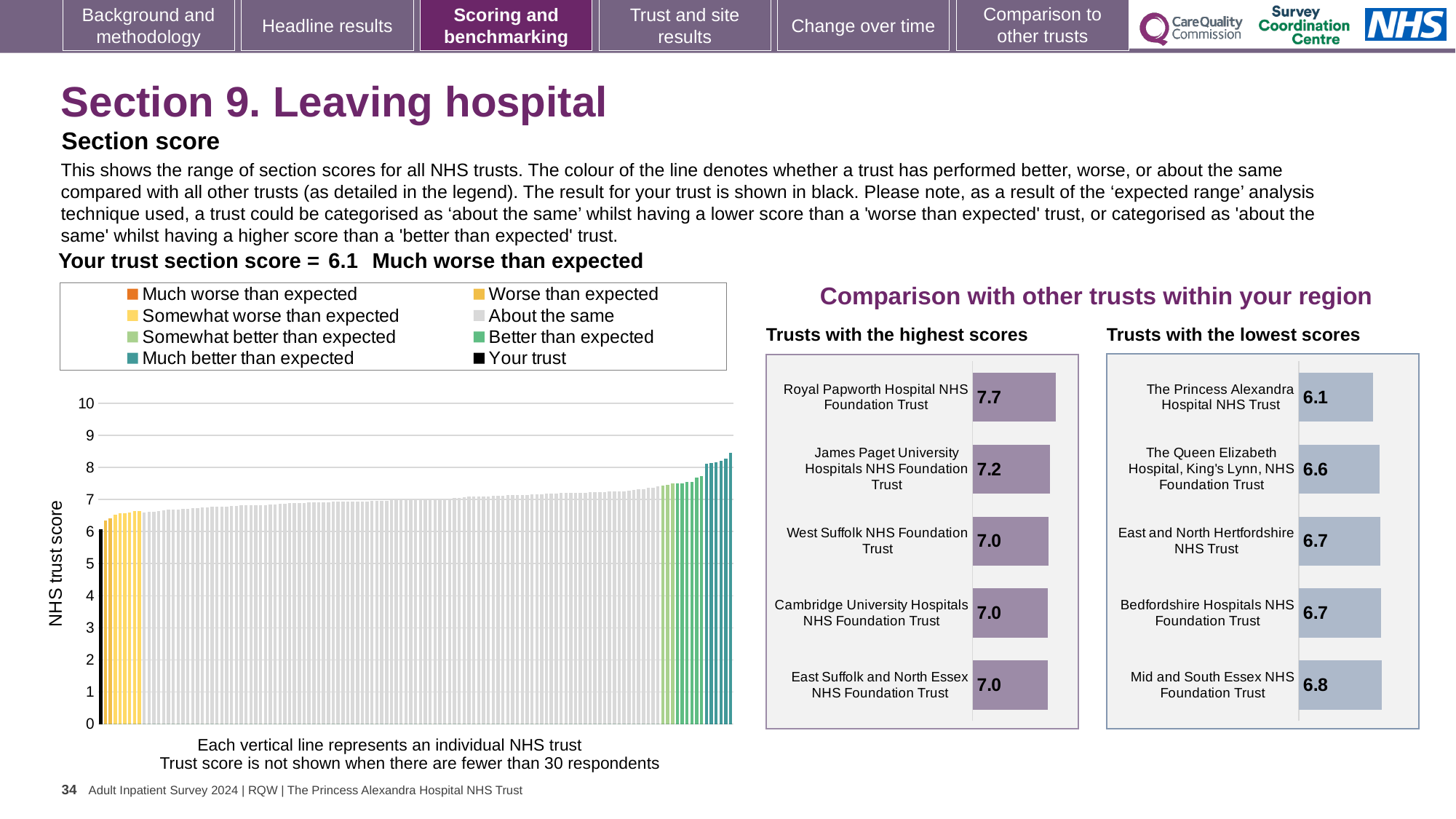
In the 'Trusts with the lowest scores' chart, which has the higher score: The Queen Elizabeth Hospital, King's Lynn, NHS Foundation Trust or East and North Hertfordshire NHS Trust? East and North Hertfordshire NHS Trust What kind of chart is the 'Trusts with the lowest scores' chart? Bar chart How many trusts are listed in the 'Trusts with the highest scores' chart? 5 In the 'Trusts with the highest scores' chart, what is the difference between the scores of Royal Papworth Hospital NHS Foundation Trust and West Suffolk NHS Foundation Trust? 0.7 In the 'Trusts with the lowest scores' chart, which trust has the lowest score? The Princess Alexandra Hospital NHS Trust In the 'Trusts with the highest scores' chart, what is the score for James Paget University Hospitals NHS Foundation Trust? 7.2 In the 'Trusts with the highest scores' chart, what is the score for Royal Papworth Hospital NHS Foundation Trust? 7.7 How many entries does the legend of the NHS trust score chart on the left list? 8 In the 'Trusts with the lowest scores' chart, what is the score for Mid and South Essex NHS Foundation Trust? 6.8 In the 'Trusts with the highest scores' chart, which trust has the highest score? Royal Papworth Hospital NHS Foundation Trust In the 'Trusts with the lowest scores' chart, what is the score for The Queen Elizabeth Hospital, King's Lynn, NHS Foundation Trust? 6.6 In the 'Trusts with the lowest scores' chart, what is the difference between the scores of Mid and South Essex NHS Foundation Trust and The Princess Alexandra Hospital NHS Trust? 0.7